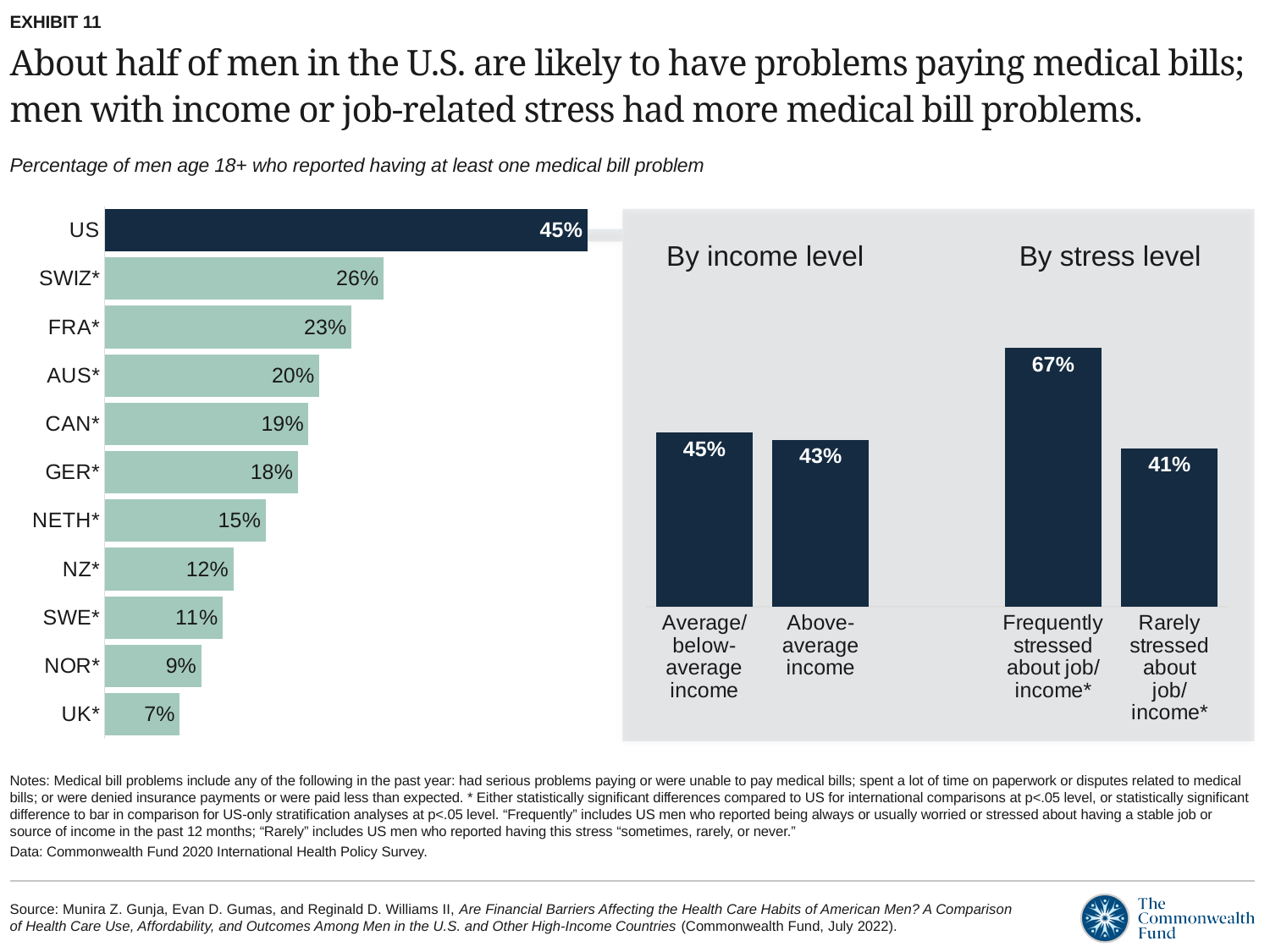
In the country bar chart on the left, which country has the lowest percentage? UK* In the 'By income level' chart, what is the value for men with above-average income? 43% In the 'By stress level' chart, what is the difference between the frequently stressed and rarely stressed values? 26 percentage points In the country bar chart on the left, which has a higher value, FRA* or AUS*? FRA* In the 'By income level' chart, which group has the higher value, average/below-average income or above-average income? Average/below-average income In the 'By stress level' chart, what is the value for men frequently stressed about job/income? 67% What kind of chart is the country chart on the left? Bar chart In the country bar chart on the left, how many countries are shown? 11 In the country bar chart on the left, what is the value for GER*? 18% In the country bar chart on the left, what percentage of men in the US reported having at least one medical bill problem? 45% In the country bar chart on the left, which country has the highest percentage? US In the country bar chart on the left, what is the difference between the US value and the SWIZ* value? 19 percentage points